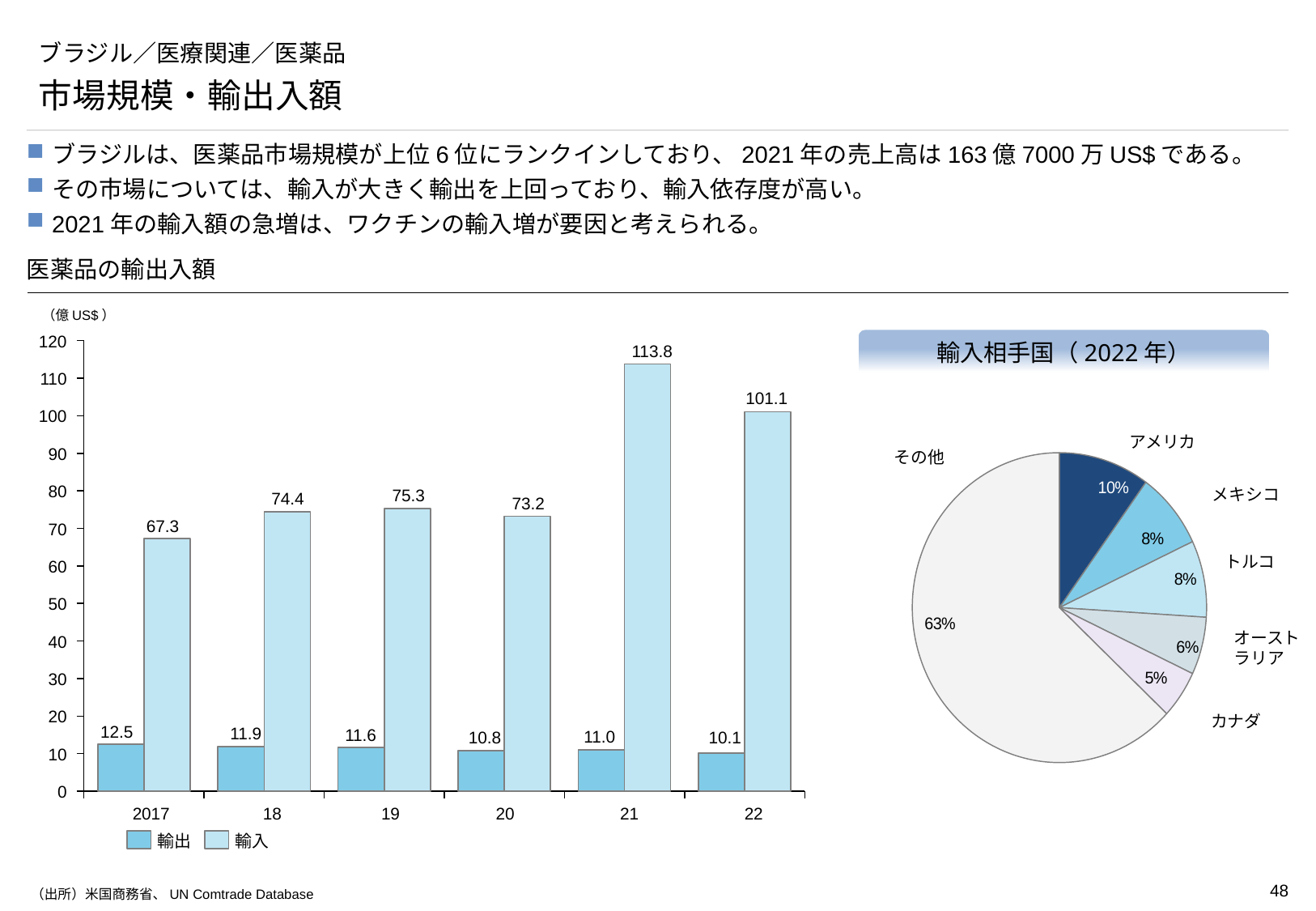
In the bar chart 医薬品の輸出入額, what is the difference between the 輸入 values for 2021 and 2022? 12.7 What kind of chart is 輸入相手国（2022年）? pie chart In the bar chart 医薬品の輸出入額, how many years are shown on the x axis? 6 In the bar chart 医薬品の輸出入額, what is the 輸出 value for 2017? 12.5 In the pie chart 輸入相手国（2022年）, which country has the smallest share among the named countries? カナダ In the bar chart 医薬品の輸出入額, how many series does the legend list? 2 In the bar chart 医薬品の輸出入額, what is the 輸入 value for 2021? 113.8 In the bar chart 医薬品の輸出入額, which is larger, the 輸入 value for 2018 or for 2019? 2019 In the pie chart 輸入相手国（2022年）, what share does アメリカ have? 10% In the bar chart 医薬品の輸出入額, which year has the lowest 輸出 value? 22 In the pie chart 輸入相手国（2022年）, what is the difference between the shares of その他 and アメリカ? 53% In the bar chart 医薬品の輸出入額, which year has the highest 輸入 value? 21